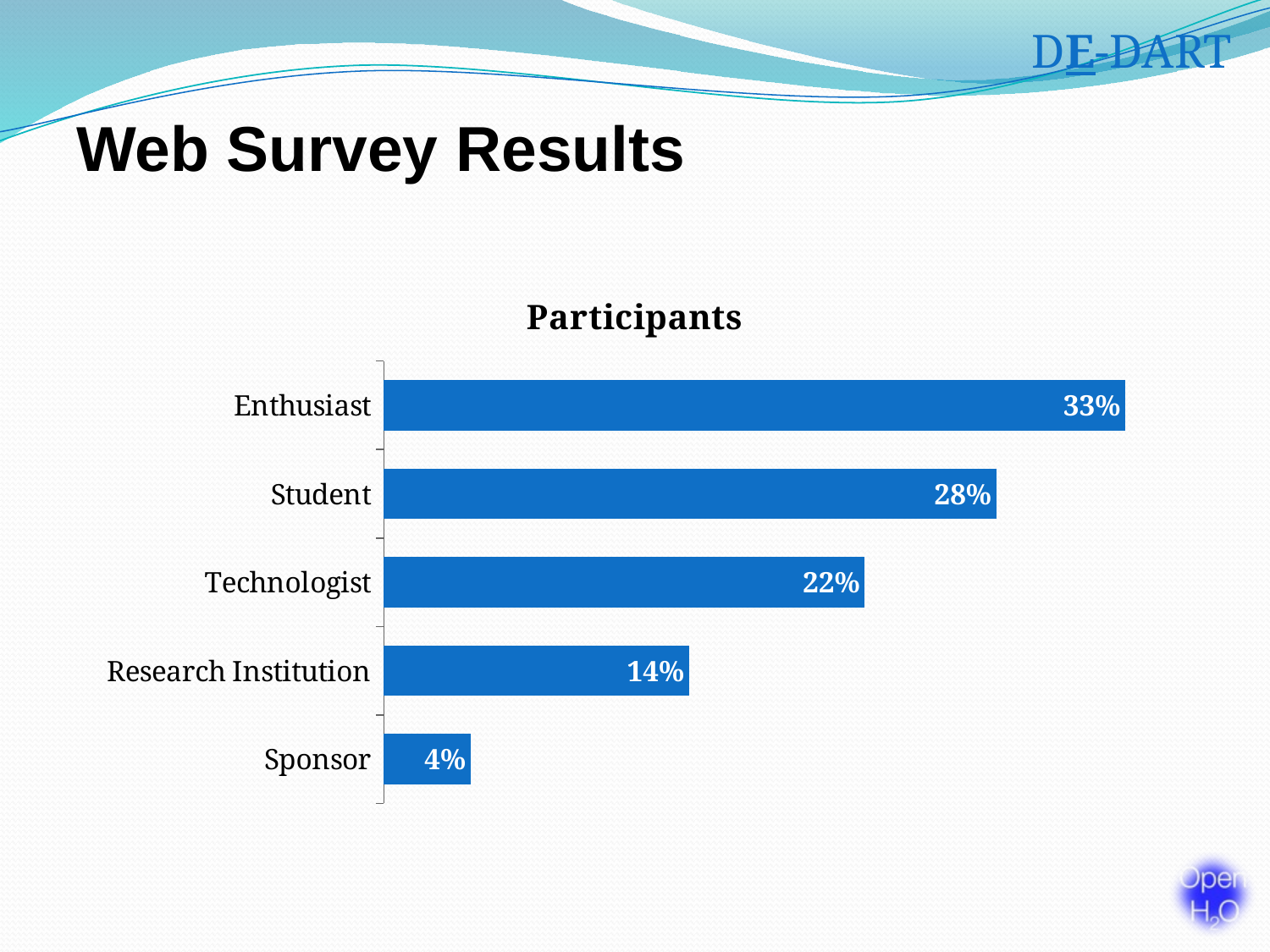
What kind of chart is shown on the slide? Bar chart What is the title of the chart? Participants Which category has the lowest value? Sponsor What is the difference between the values for Enthusiast and Student? 5% What is the value for Student? 28% What is the value for Research Institution? 14% How many categories are shown in the chart? 5 What is the value for Enthusiast? 33% Which is larger, the value for Technologist or the value for Research Institution? Technologist What is the difference between the values for Technologist and Sponsor? 18% Which category has the highest value? Enthusiast What is the value for Sponsor? 4%